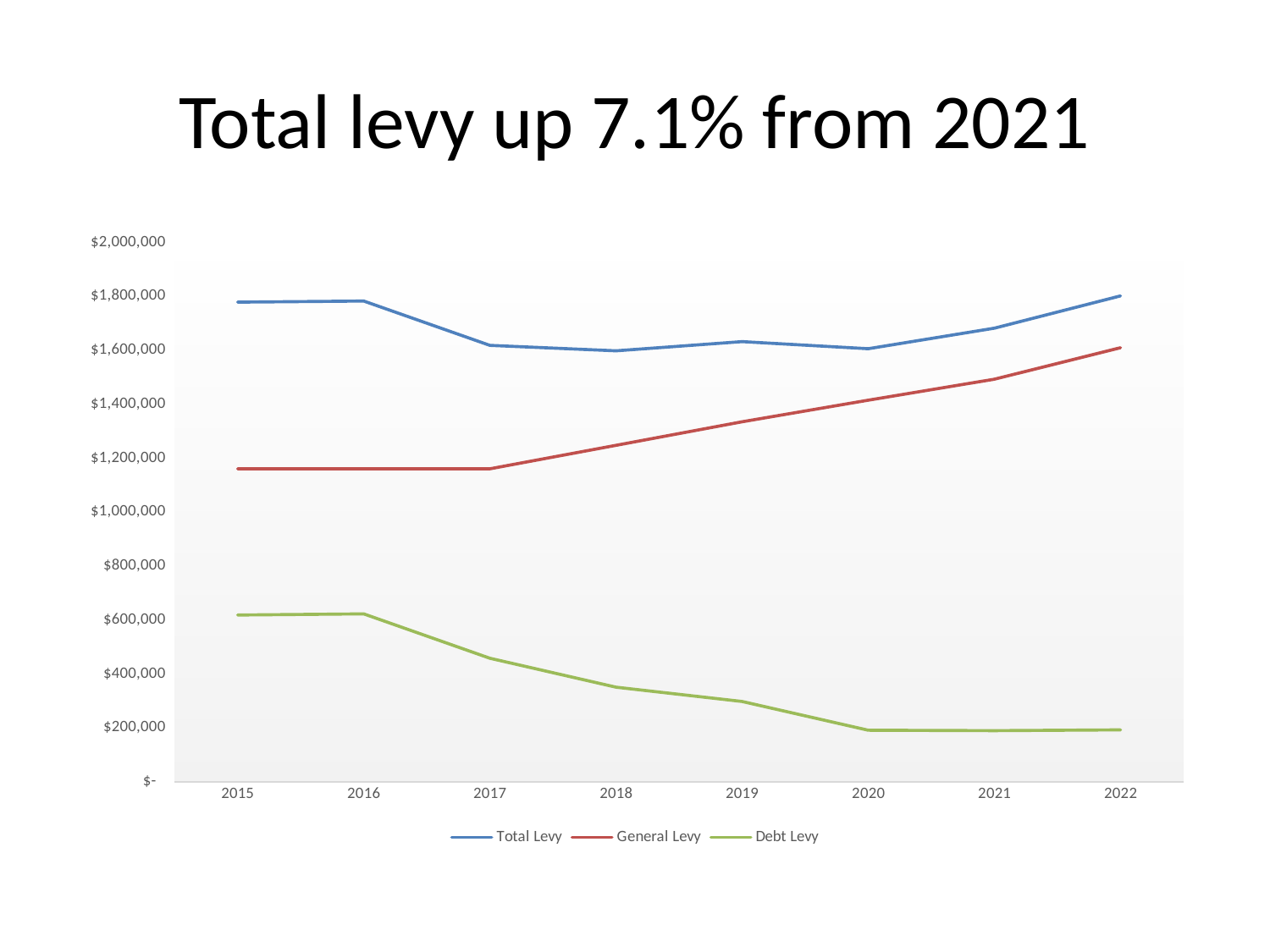
Is the Debt Levy value for 2018 greater or less than $400,000? less How many years are shown on the x axis? 8 In which year is the General Levy highest? 2022 How many series does the legend list? 3 What is the title of the slide? Total levy up 7.1% from 2021 What kind of chart is shown on the slide? Line chart Which is larger in 2015, the Total Levy or the General Levy? Total Levy Is the General Levy value for 2018 greater or less than $1,200,000? greater Does the General Levy rise or fall from 2017 to 2022? Rise Does the Debt Levy rise or fall from 2016 to 2020? Fall Is the General Levy value for 2021 greater or less than $1,600,000? less